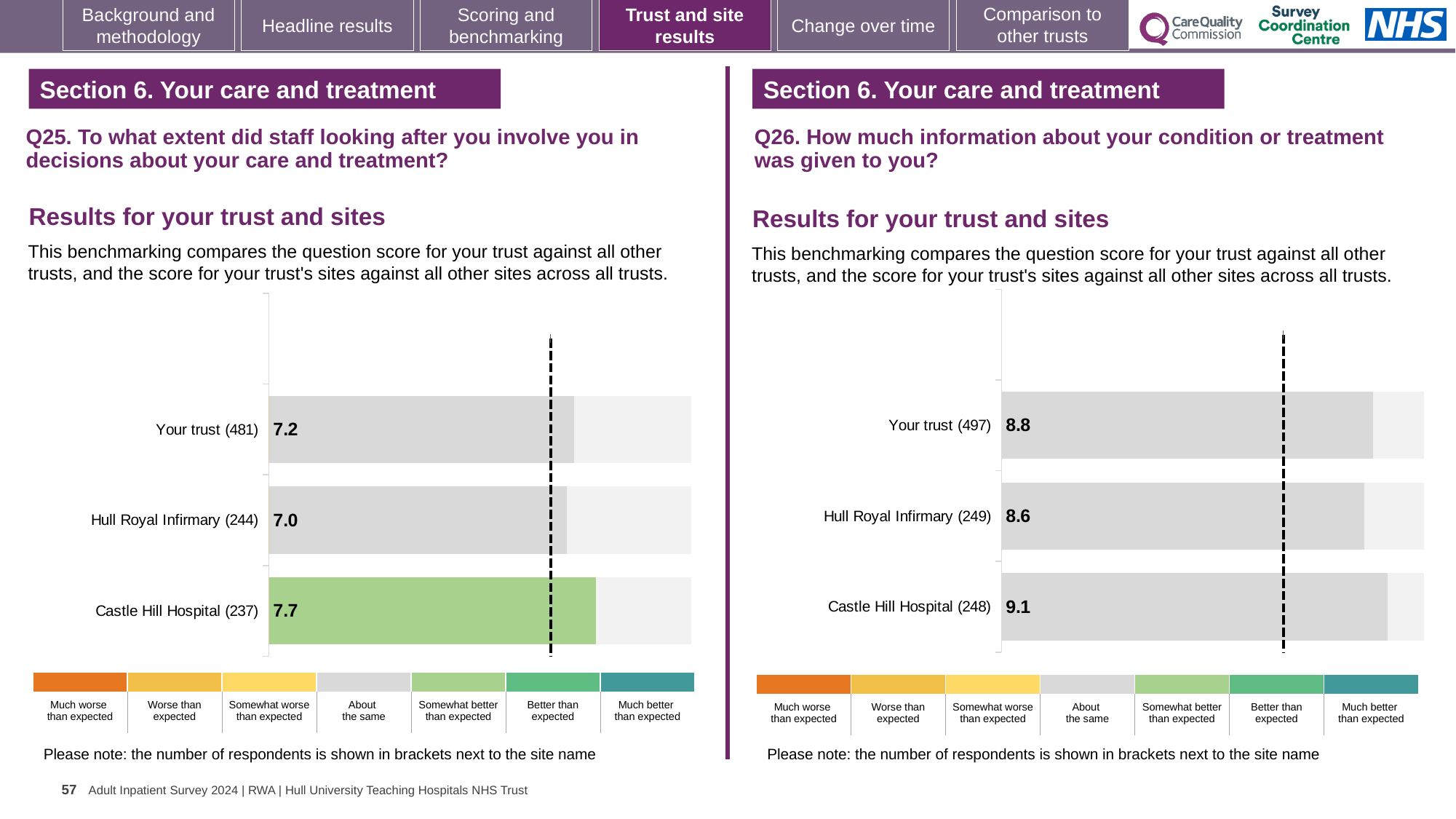
In the Q25 chart on the left, what is the difference between the Castle Hill Hospital score and the Hull Royal Infirmary score? 0.7 In the Q25 chart on the left, what is the score for Castle Hill Hospital? 7.7 In the Q26 chart on the right, what is the score for Castle Hill Hospital? 9.1 In the Q26 chart on the right, what is the score for Your trust? 8.8 In the Q26 chart on the right, what is the difference between the Castle Hill Hospital score and the Your trust score? 0.3 In the Q26 chart on the right, which row has the lowest score? Hull Royal Infirmary In the Q25 chart on the left, what is the score for Hull Royal Infirmary? 7.0 In the Q25 chart on the left, which bar is coloured green? Castle Hill Hospital In the Q25 chart on the left, how many bars are plotted? 3 What type of chart is used for the Q25 results on the left? bar chart In the Q25 chart on the left, which site or trust row has the highest score? Castle Hill Hospital In the Q26 chart on the right, is the score for Castle Hill Hospital larger or smaller than the score for Your trust? larger